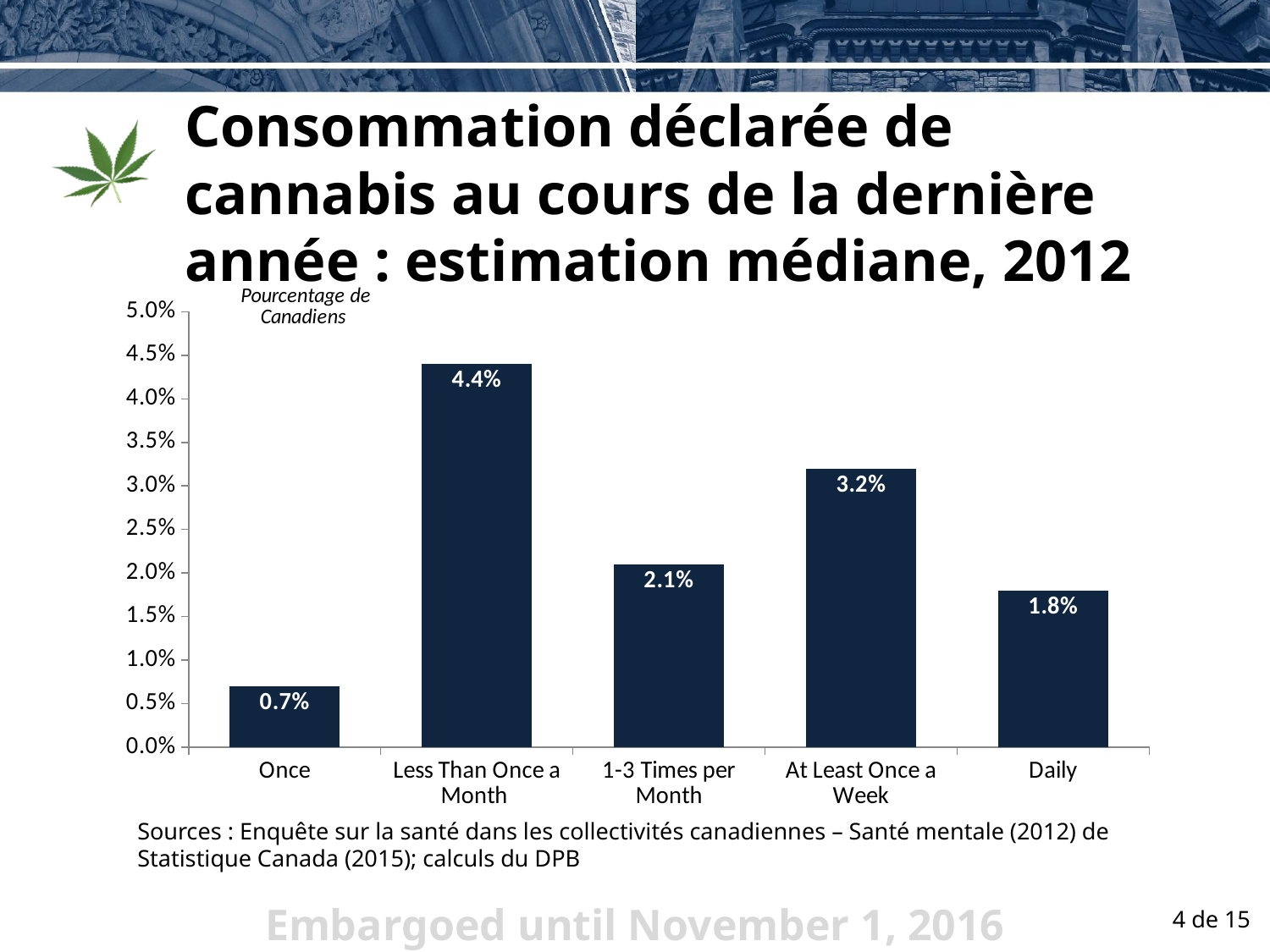
What is the value for "Once"? 0.7% What is the value for "Less Than Once a Month"? 4.4% Which category has the lowest value? Once How many categories are shown on the x axis? 5 Which category has the highest value? Less Than Once a Month What is the label on the vertical axis of the chart? Pourcentage de Canadiens Which is larger, the value for "1-3 Times per Month" or the value for "Daily"? 1-3 Times per Month What is the difference between the values for "At Least Once a Week" and "1-3 Times per Month"? 1.1% What is the difference between the values for "Less Than Once a Month" and "Daily"? 2.6% What kind of chart is shown on the slide? Bar chart Is the value for "At Least Once a Week" greater or less than 3.0%? greater What is the value for "Daily"? 1.8%